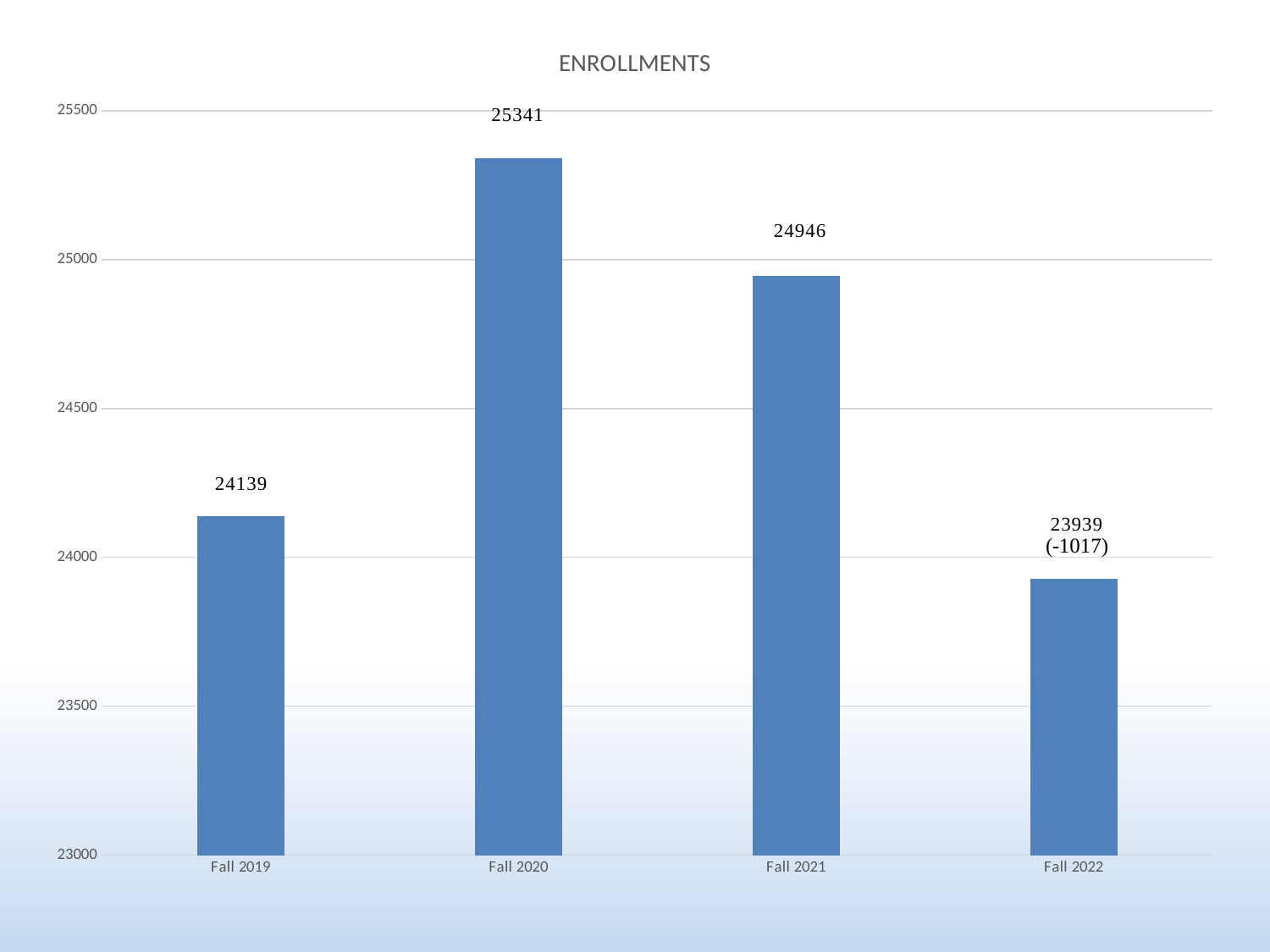
What is the difference in enrollment between Fall 2020 and Fall 2021? 395 What is the enrollment value for Fall 2019? 24139 What is the enrollment value for Fall 2021? 24946 How many terms are shown on the chart? 4 What is the enrollment value for Fall 2020? 25341 What type of chart is shown on the slide? bar chart What is the enrollment value for Fall 2022? 23939 Which term has the highest enrollment? Fall 2020 Is the value for Fall 2022 greater or less than 24000? less Which has the larger enrollment, Fall 2019 or Fall 2021? Fall 2021 Which term has the lowest enrollment? Fall 2022